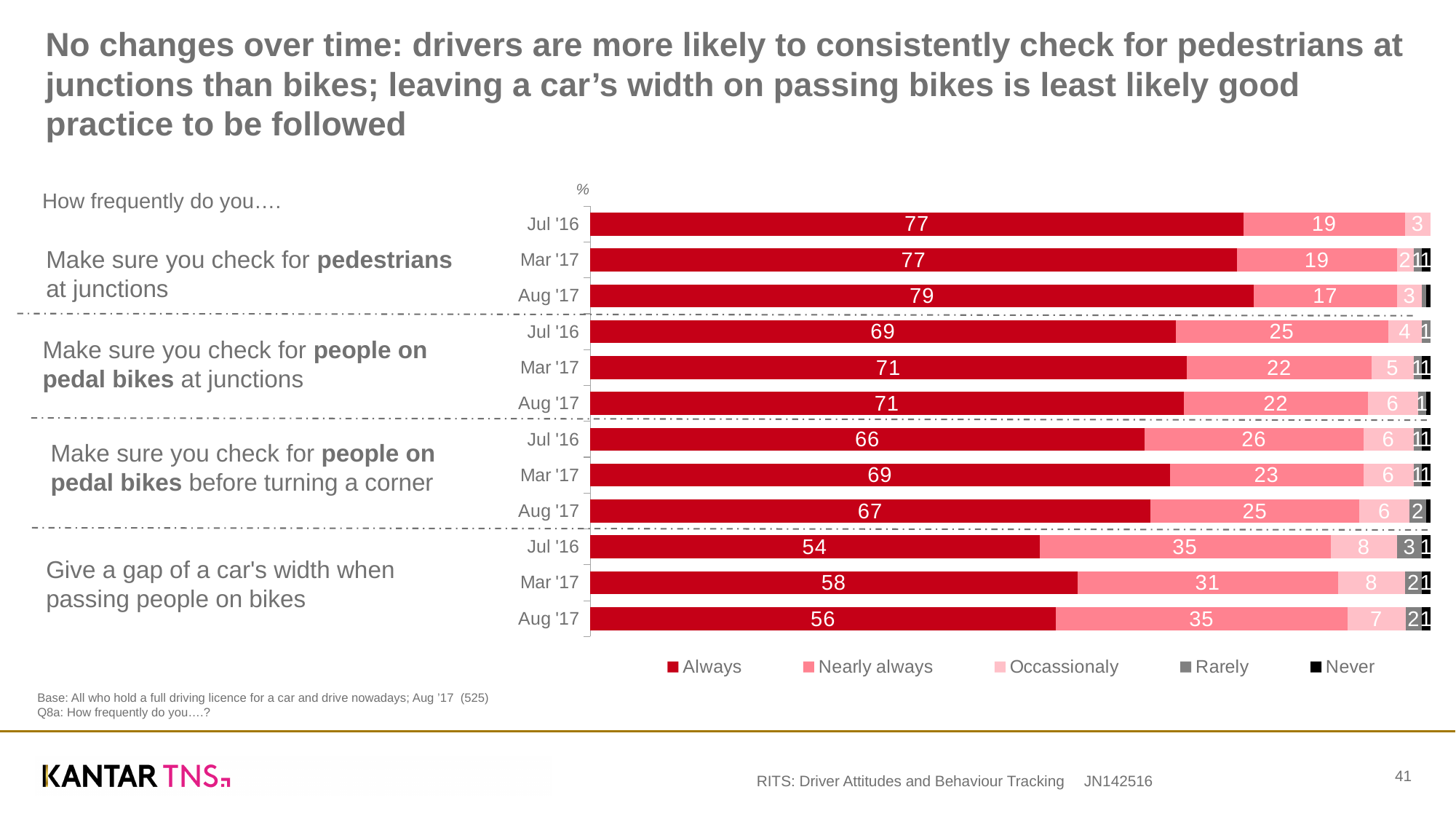
How many bars are plotted in the chart? 12 Which bar has the highest 'Always' value? Aug '17, check for pedestrians at junctions (79) In Aug '17, how many percentage points higher is the 'Always' value for checking for pedestrians at junctions than for checking for people on pedal bikes at junctions? 8 Which bar has the lowest 'Always' value? Jul '16, give a gap of a car's width when passing people on bikes (54) What percentage said they 'Always' give a gap of a car's width when passing people on bikes in Jul '16? 54 How many series does the legend list? 5 What is the 'Nearly always' value for 'Make sure you check for people on pedal bikes at junctions' in Mar '17? 22 What is the 'Nearly always' value for 'Give a gap of a car's width when passing people on bikes' in Jul '16? 35 For 'Give a gap of a car's width when passing people on bikes', which wave has the larger 'Always' value: Mar '17 or Aug '17? Mar '17 What percentage of drivers said they 'Always' make sure they check for pedestrians at junctions in Aug '17? 79 What is the 'Occassionaly' value for 'Give a gap of a car's width when passing people on bikes' in Aug '17? 7 What kind of chart is shown on the slide? Stacked bar chart